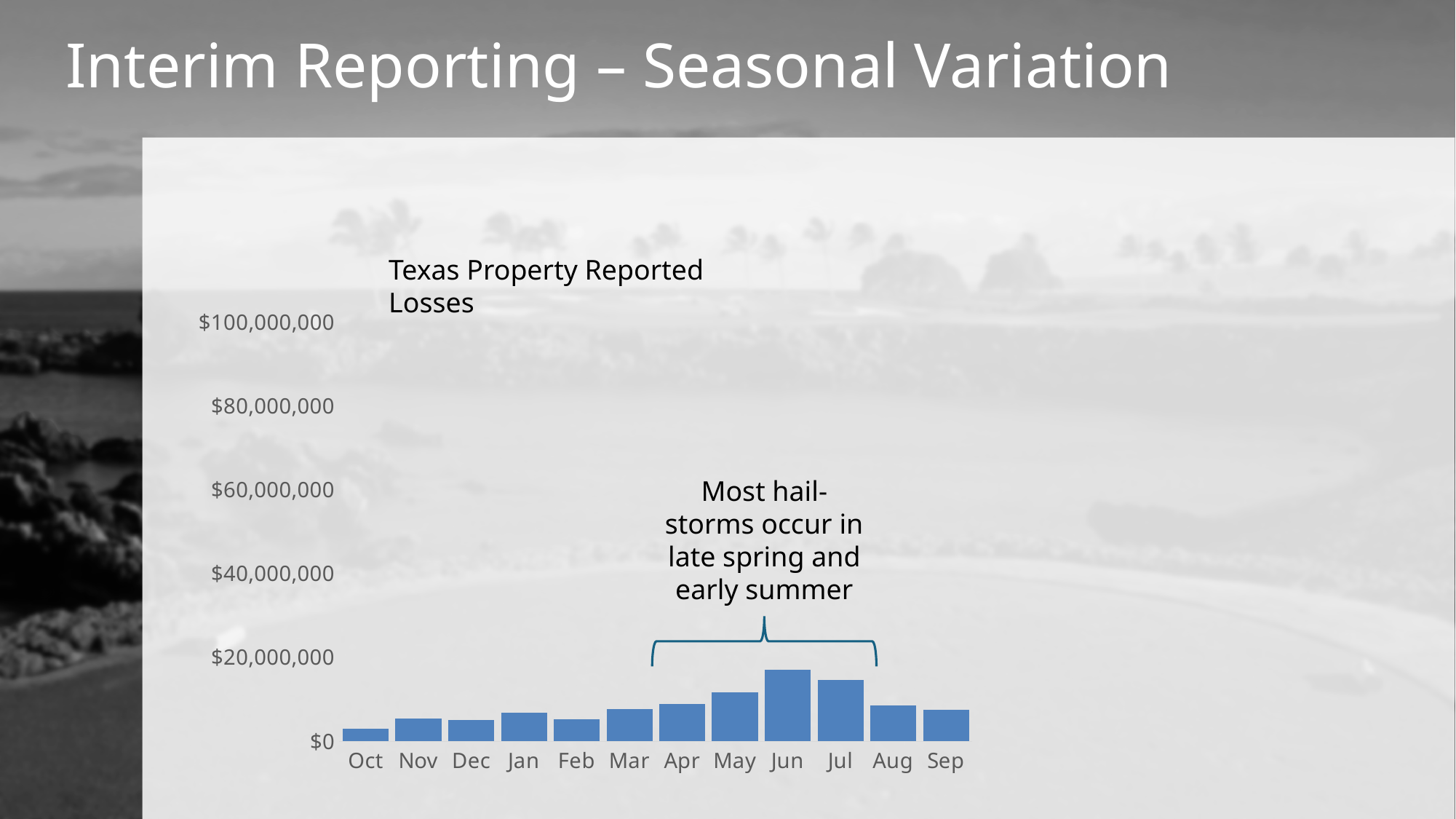
Which month has the highest reported losses? Jun According to the annotation on the chart, when do most hailstorms occur? Late spring and early summer Which month has higher reported losses, Apr or May? May Is the value for Jun greater or less than $20,000,000? less What is the title of the chart? Texas Property Reported Losses How many months are plotted on the x axis of the chart? 12 Which month has higher reported losses, Feb or Mar? Mar Do the reported losses rise or fall from Jun to Sep? Fall Which month has the lowest reported losses? Oct Do the reported losses rise or fall from Mar to Jun? Rise What kind of chart is shown on the slide? Bar chart Which month has higher reported losses, Jun or Jul? Jun